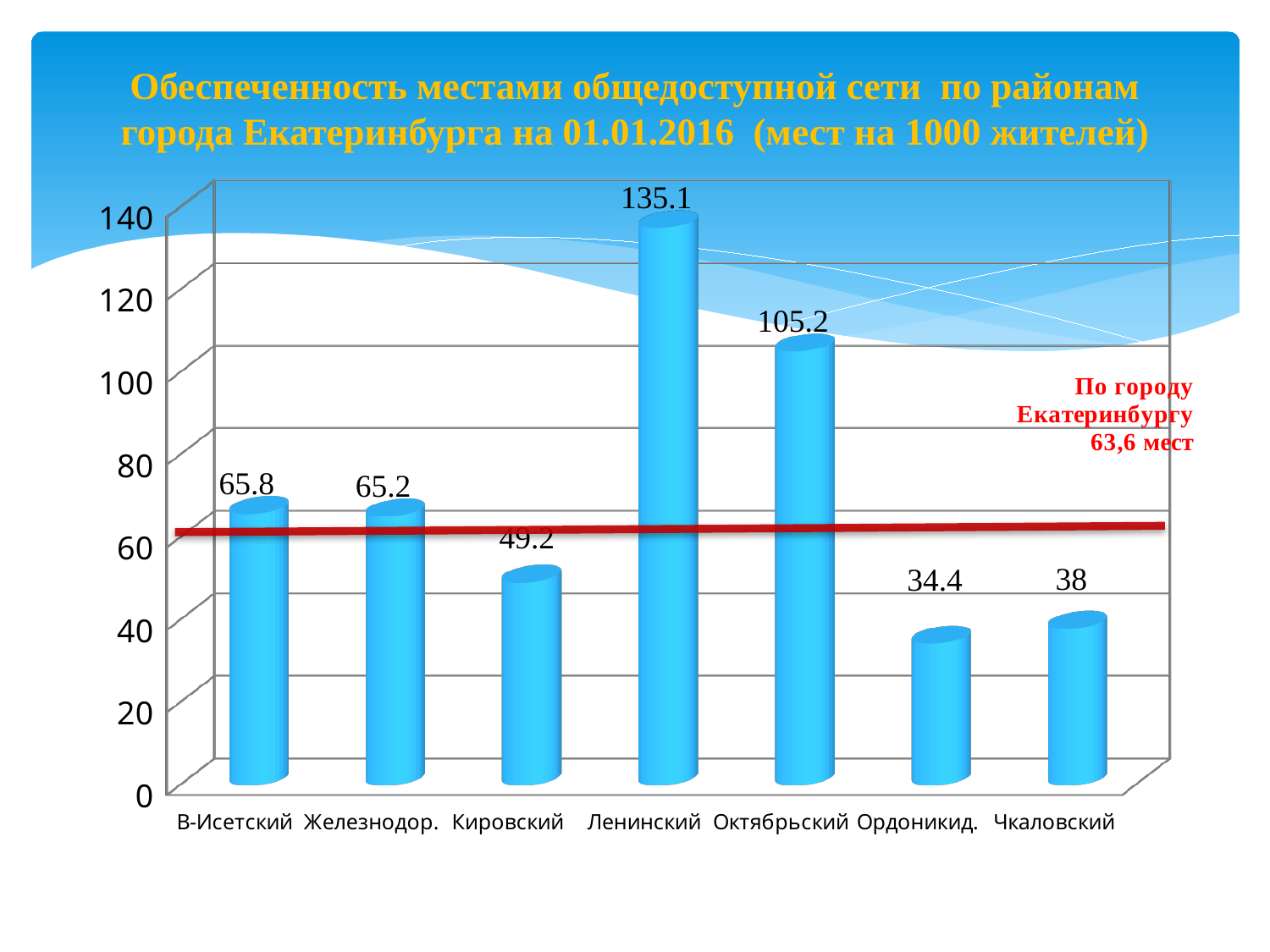
How many districts are shown on the chart? 7 What is the value for Ленинский? 135.1 What is the difference between the values for Ленинский and Октябрьский? 29.9 What kind of chart is shown on the slide? bar chart What value does the red horizontal line across the chart represent for the city of Екатеринбург? 63,6 мест Which is larger, the value for Октябрьский or the value for В-Исетский? Октябрьский Is the value for Кировский greater or less than 60? less Which district has the highest value? Ленинский What is the value for Кировский? 49.2 What is the value for Чкаловский? 38 What is the difference between the values for Чкаловский and Ордоникид.? 3.6 Which district has the lowest value? Ордоникид.